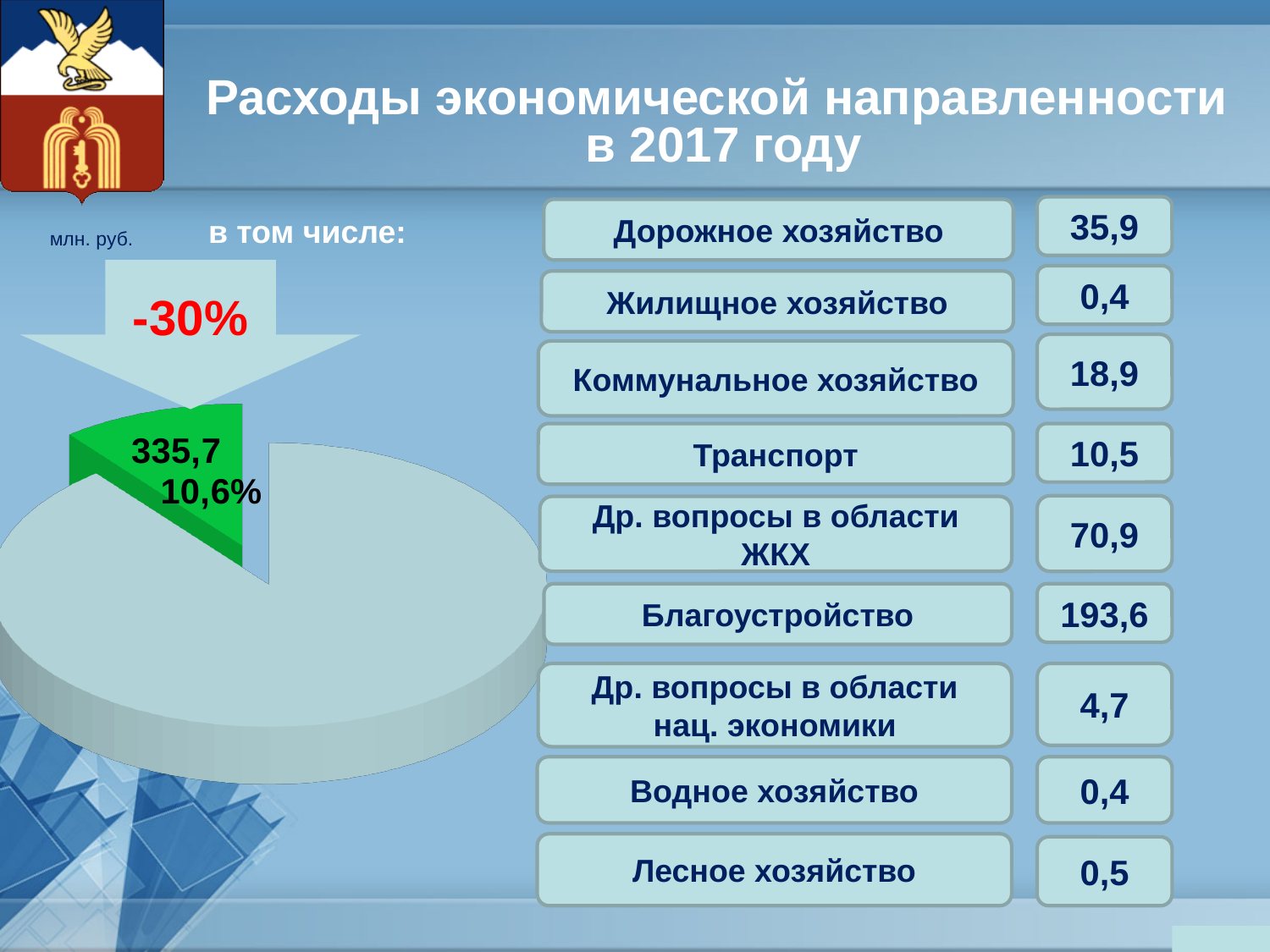
What unit is indicated for the values on the pie chart? млн. руб. What kind of chart is shown on the left of the slide? pie chart How many slices does the pie chart have? 2 What value is printed on the green slice of the pie chart? 335,7 Which slice of the pie chart is larger, the green slice or the light blue slice? the light blue slice What share of the pie does the green slice represent, as printed on the chart? 10,6% Is the share of the green slice greater or less than 50%? less What percentage change is shown in the arrow above the pie chart? -30%